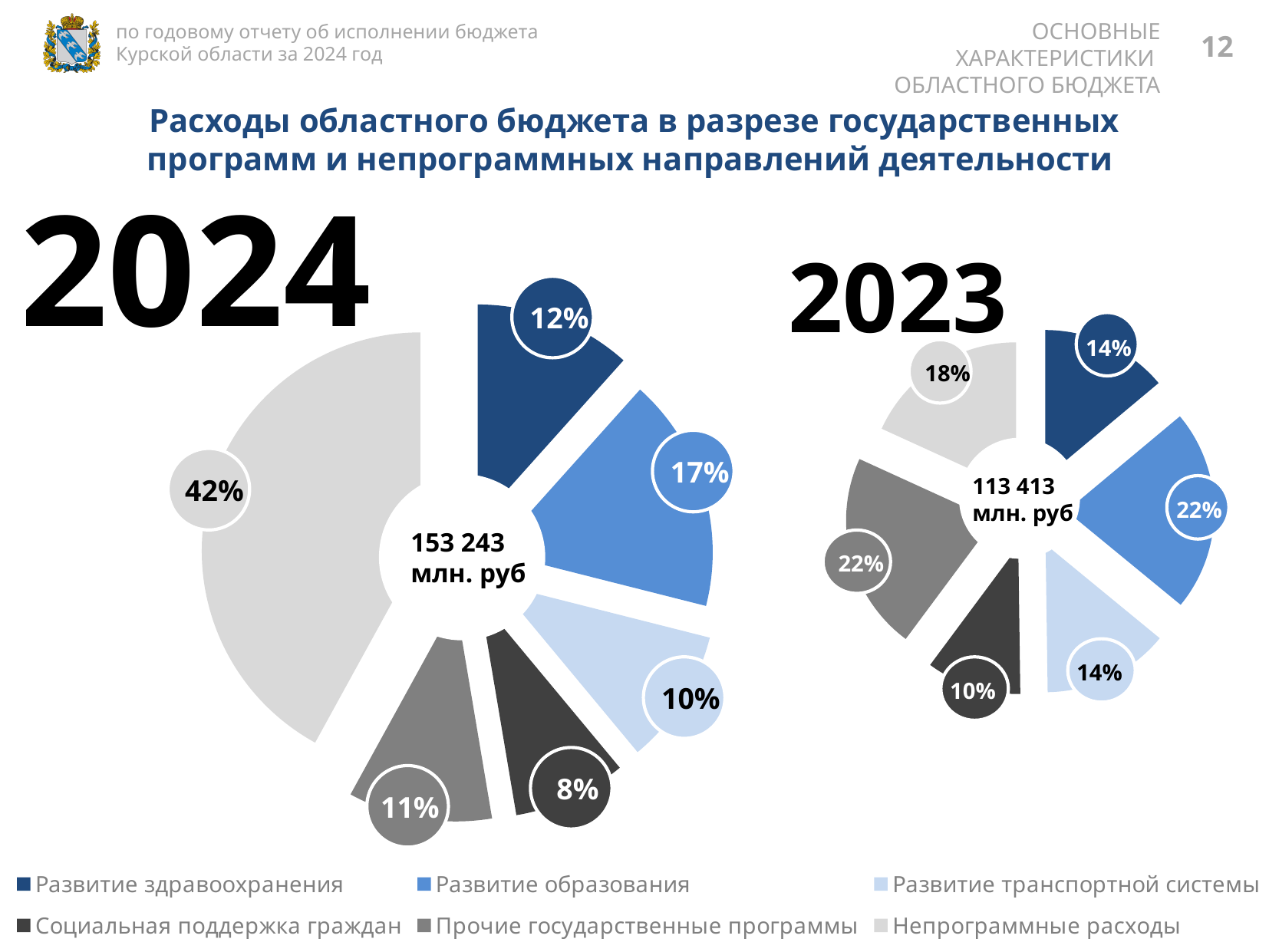
In the 2023 chart, which is larger: Развитие образования or Непрограммные расходы? Развитие образования In the 2023 chart, which category has the smallest share? Социальная поддержка граждан How many categories does the legend list? 6 In the 2023 chart, what share is Развитие здравоохранения? 14% In the 2024 chart, what is the difference between the shares of Развитие образования and Развитие здравоохранения? 5% In the 2024 chart, which category has the smallest share? Социальная поддержка граждан What total amount is shown in the centre of the 2023 chart? 113 413 млн. руб In the 2023 chart, what share is Социальная поддержка граждан? 10% In the 2024 chart, what share is Развитие образования? 17% What total amount is shown in the centre of the 2024 chart? 153 243 млн. руб In the 2024 chart, what share of expenditures is Непрограммные расходы? 42% In the 2024 chart, which category has the largest share? Непрограммные расходы